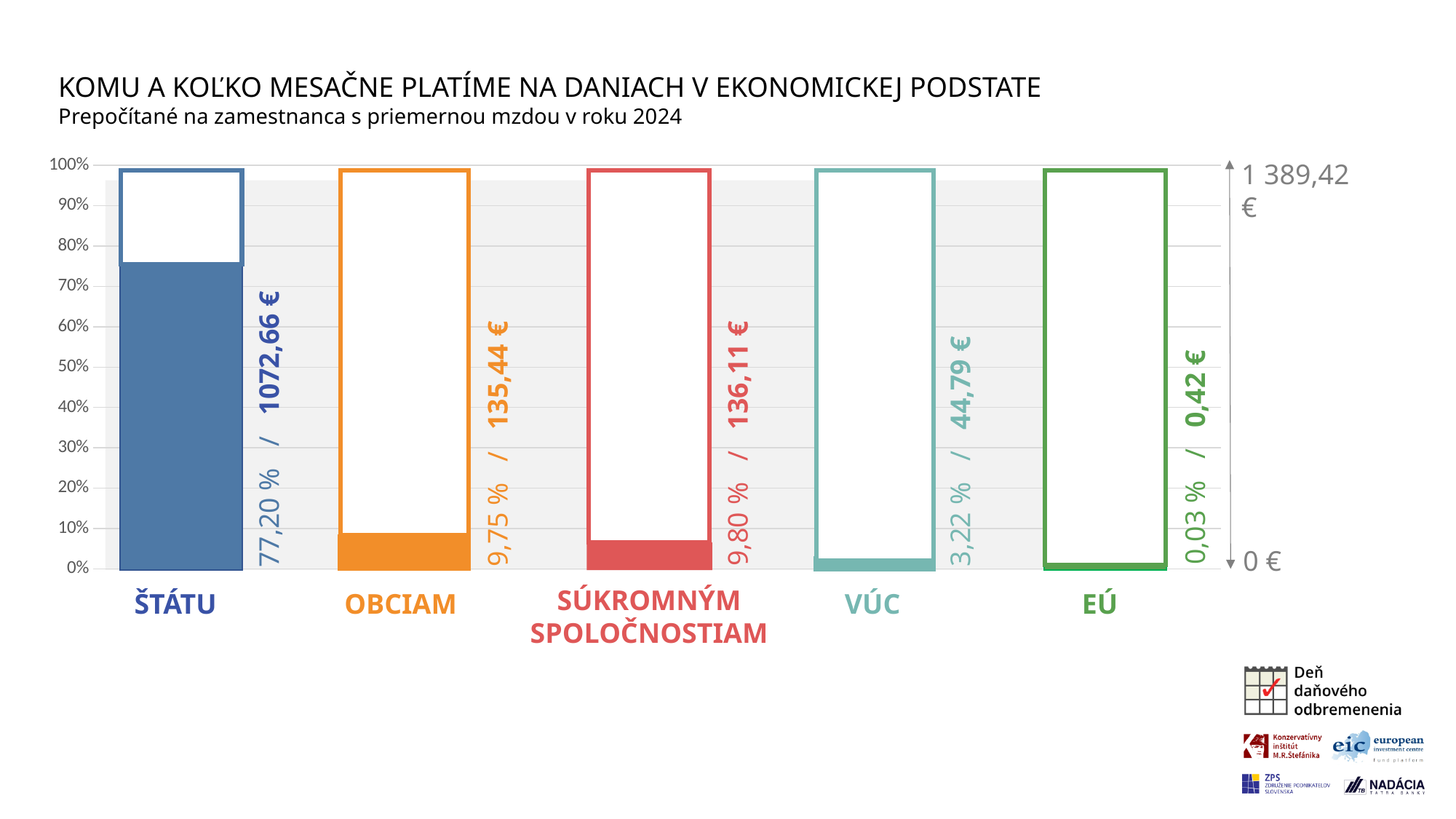
What monthly amount in euros is shown for ŠTÁTU? 1072,66 € What percentage share is shown for EÚ? 0,03 % How many categories are shown on the x axis? 5 What total amount in euros is shown at the top of the right-hand scale? 1 389,42 € What kind of chart is this? bar chart Which is larger, the amount for OBCIAM or for SÚKROMNÝM SPOLOČNOSTIAM? SÚKROMNÝM SPOLOČNOSTIAM Which category has the lowest share? EÚ What monthly amount in euros is shown for SÚKROMNÝM SPOLOČNOSTIAM? 136,11 € What percentage share is shown for OBCIAM? 9,75 % Which category has the highest share? ŠTÁTU What is the difference in euros between the amounts for SÚKROMNÝM SPOLOČNOSTIAM and OBCIAM? 0,67 € What monthly amount in euros is shown for VÚC? 44,79 €